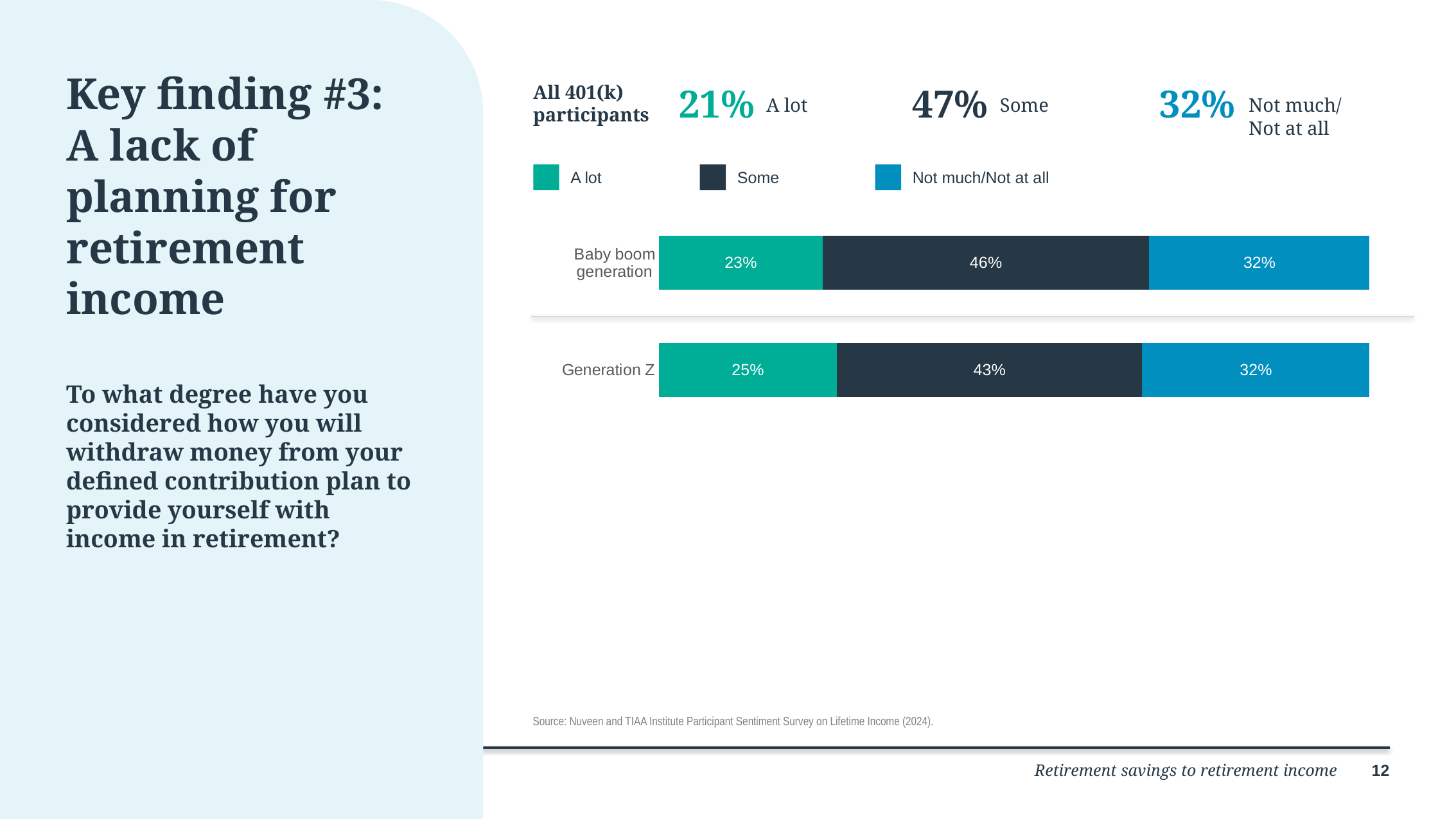
How many series does the legend list? 3 What percentage of the Baby boom generation answered "Some"? 46% What is the total of the Generation Z stacked bar? 100% What percentage of Generation Z answered "Some"? 43% Which response category has the smallest share for Generation Z? A lot What percentage of the Baby boom generation answered "A lot"? 23% What percentage of Generation Z answered "Not much/Not at all"? 32% What kind of chart is shown on the slide? Stacked bar chart Which response category has the largest share for the Baby boom generation? Some Which generation has the larger "A lot" share, Baby boom generation or Generation Z? Generation Z What is the difference between the "Some" share for the Baby boom generation and for Generation Z? 3 percentage points How many generation categories are shown in the bar chart? 2